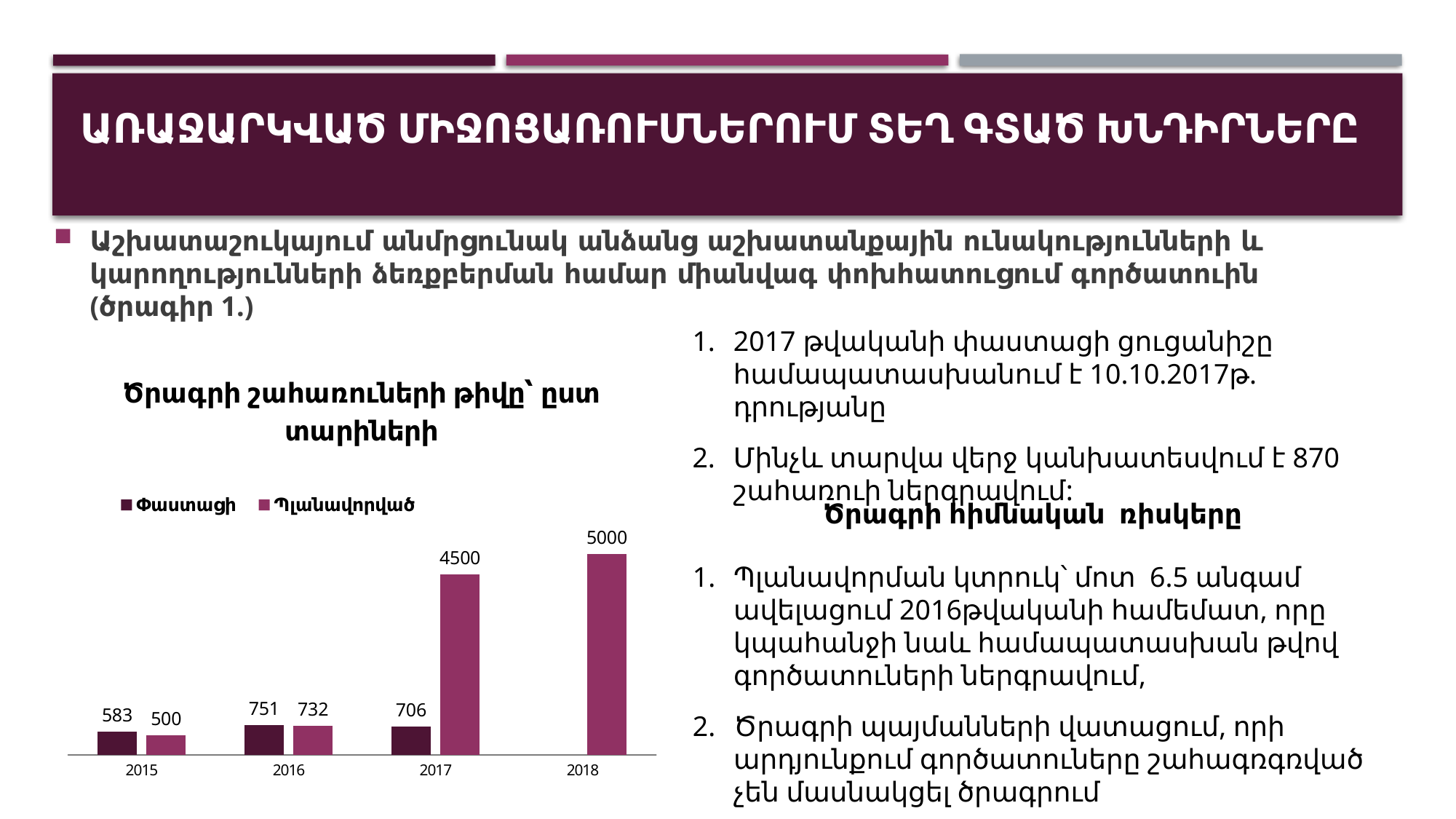
Which year has the highest Պլանավորված value? 2018 What is the difference between the Պլանավորված and Փաստացի values for 2017? 3794 How many years are shown on the x axis of the chart? 4 How many series does the chart legend list? 2 Which is larger for 2015, the Փաստացի value or the Պլանավորված value? Փաստացի What is the Պլանավորված value for 2018? 5000 What is the Փաստացի value for 2015? 583 What is the title of the chart? Ծրագրի շահառուների թիվը՝ ըստ տարիների Which year has the lowest Պլանավորված value? 2015 What kind of chart is shown on the slide? bar chart What is the Փաստացի value for 2016? 751 What is the Պլանավորված value for 2017? 4500